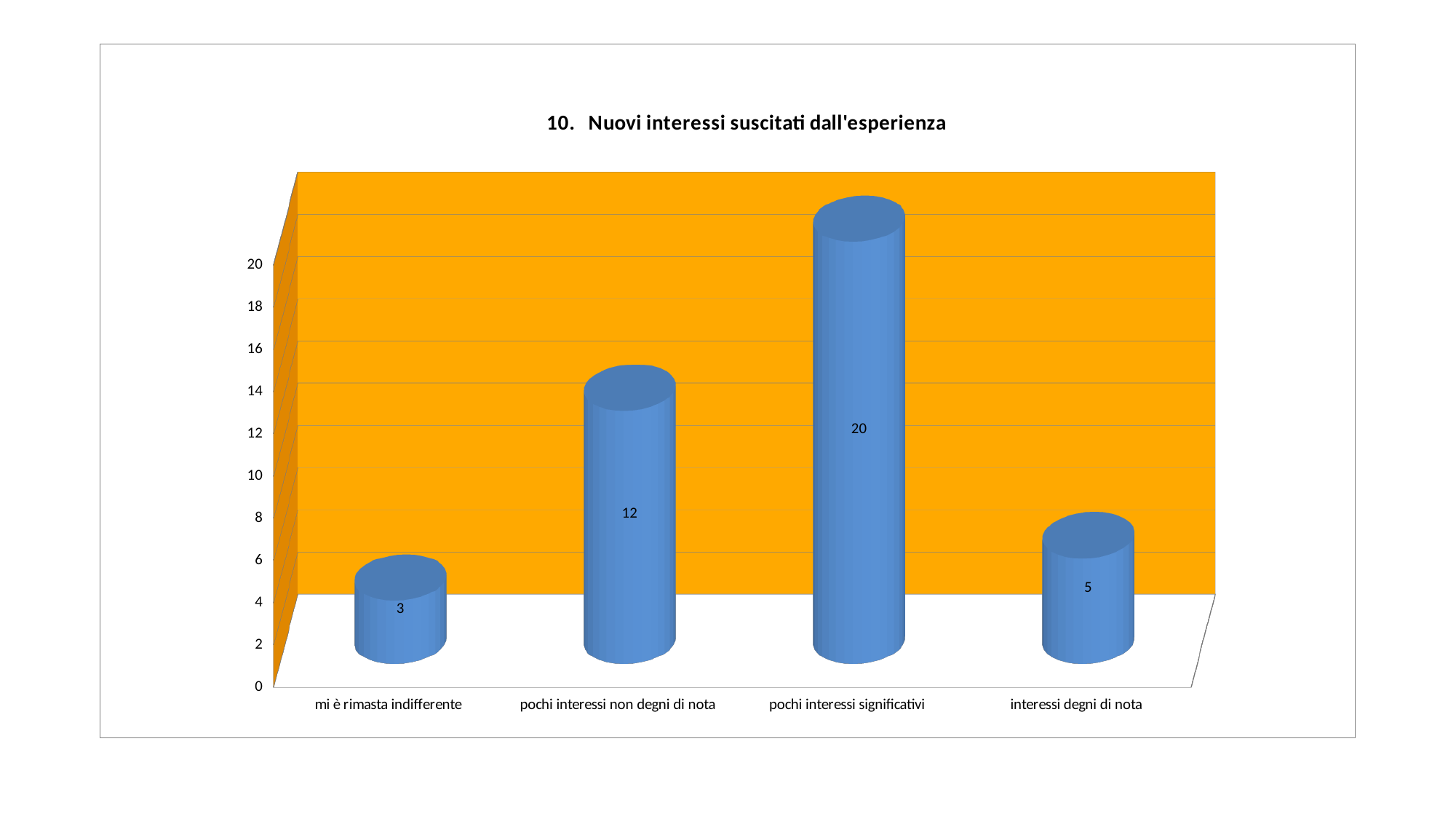
What is the difference between the values for "pochi interessi significativi" and "pochi interessi non degni di nota"? 8 What is the total of all four values shown in the chart? 40 Which is larger, the value for "interessi degni di nota" or the value for "mi è rimasta indifferente"? interessi degni di nota What is the value for "interessi degni di nota"? 5 Which category has the lowest value? mi è rimasta indifferente What kind of chart is shown on the slide? bar chart What is the value for "mi è rimasta indifferente"? 3 What is the title of the chart? 10. Nuovi interessi suscitati dall'esperienza How many categories are shown on the x axis? 4 What is the value for "pochi interessi significativi"? 20 What is the value for "pochi interessi non degni di nota"? 12 Which category has the highest value? pochi interessi significativi